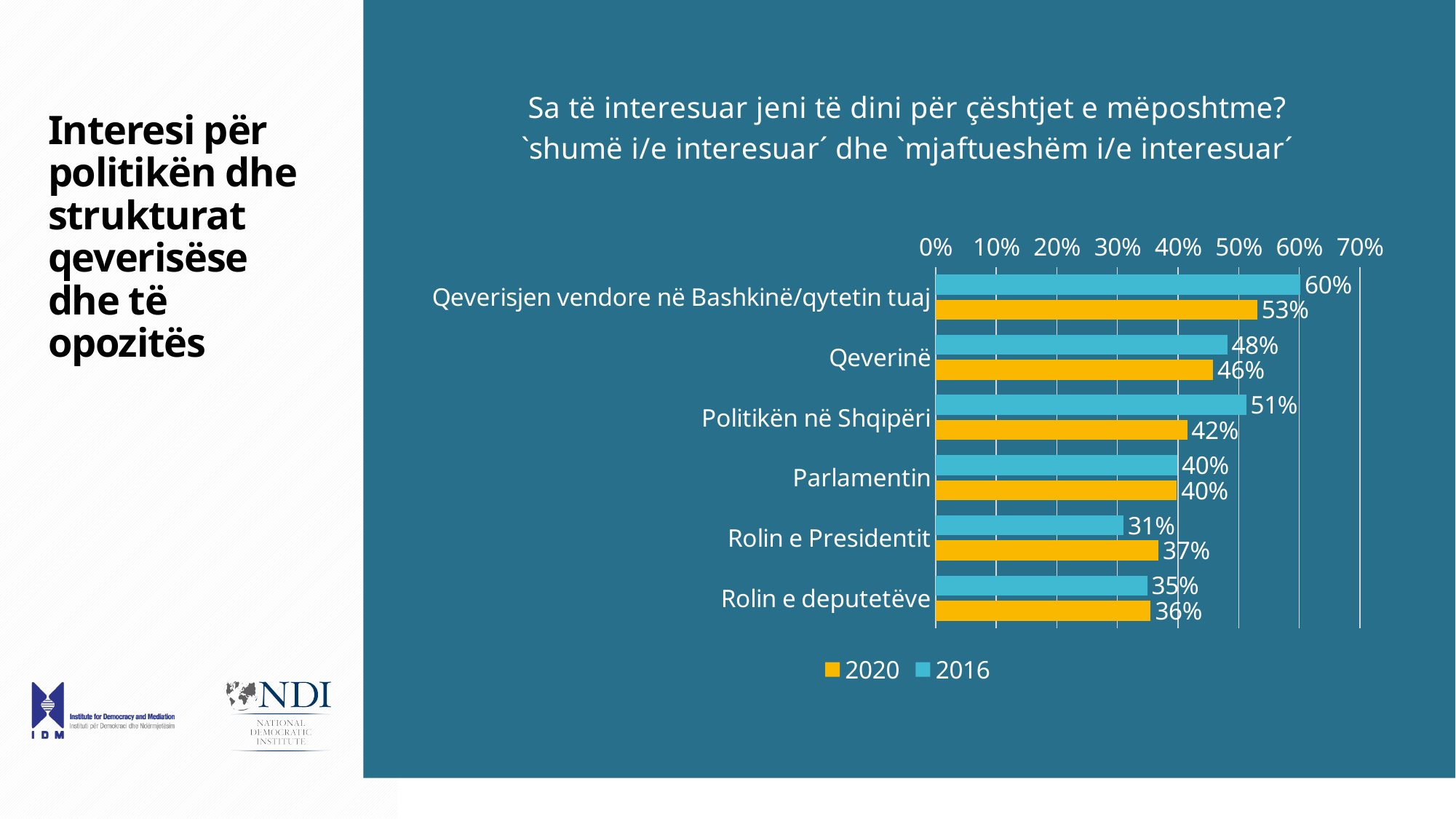
What is the 2020 value for Rolin e Presidentit? 37% What kind of chart is shown on the slide? Bar chart What is the 2016 value for Parlamentin? 40% How many categories are shown on the chart? 6 What is the 2020 value for Politikën në Shqipëri? 42% What is the difference between the 2016 and 2020 values for Politikën në Shqipëri? 9% Which colour represents the 2020 series in the legend? Yellow Which category has the highest 2020 value? Qeverisjen vendore në Bashkinë/qytetin tuaj How many series does the legend list? 2 Which category has the lowest 2016 value? Rolin e Presidentit Which is larger for Rolin e Presidentit, the 2020 value or the 2016 value? 2020 What is the 2016 value for Qeverisjen vendore në Bashkinë/qytetin tuaj? 60%